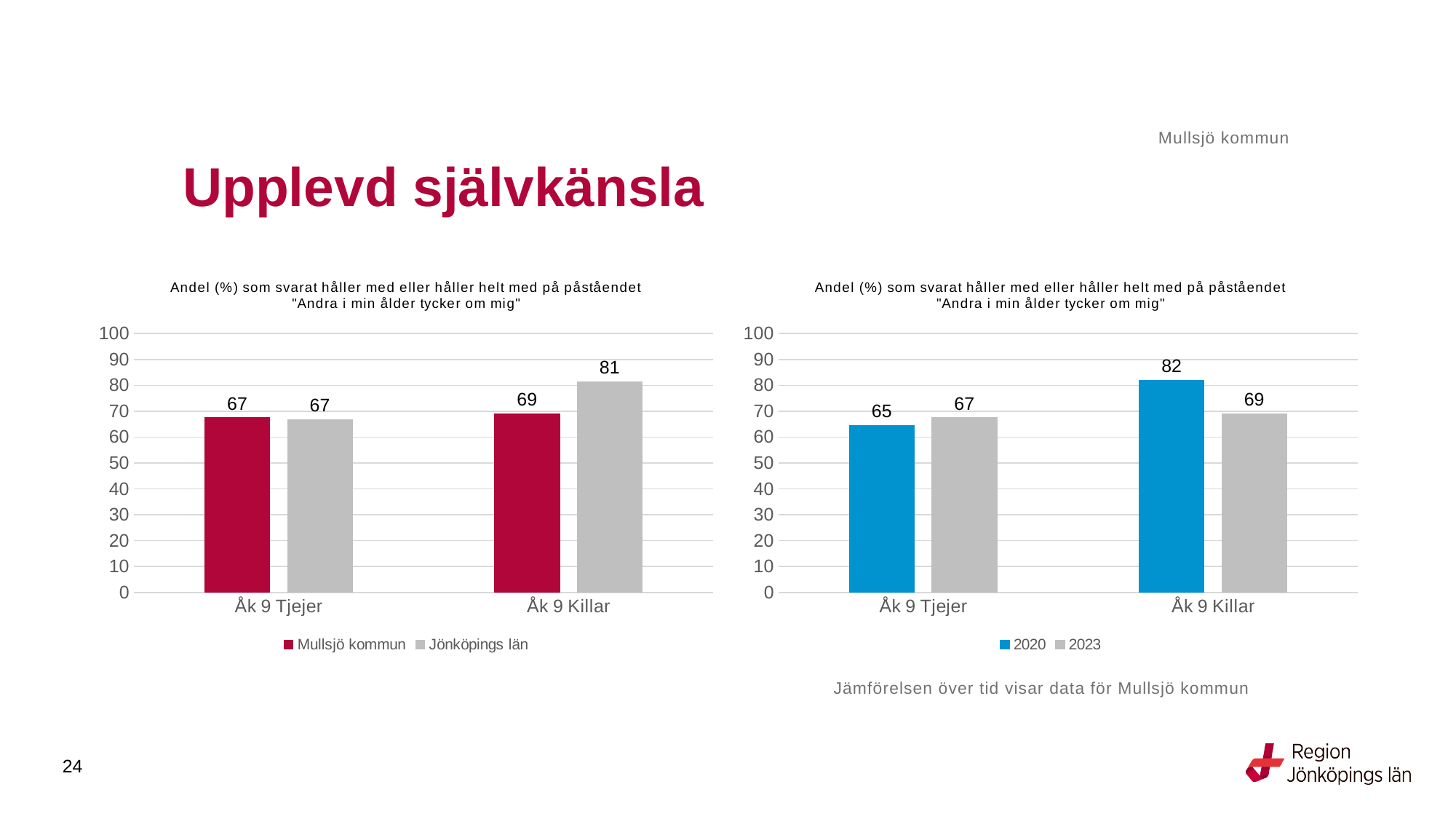
What kind of chart is the left chart? Bar chart In the right chart, what is the value for 2023 for Åk 9 Tjejer? 67 In the left chart, what is the value for Jönköpings län for Åk 9 Killar? 81 In the left chart, which series has the higher value for Åk 9 Killar, Mullsjö kommun or Jönköpings län? Jönköpings län In the right chart, which category has the highest value in the 2020 series? Åk 9 Killar In the left chart, what is the value for Mullsjö kommun for Åk 9 Killar? 69 How many series does the legend of the right chart list? 2 In the right chart, what is the value for 2020 for Åk 9 Killar? 82 In the right chart, what is the difference between 2020 and 2023 for Åk 9 Killar? 13 In the left chart, what is the value for Mullsjö kommun for Åk 9 Tjejer? 67 In the left chart, what is the difference between Jönköpings län and Mullsjö kommun for Åk 9 Killar? 12 In the right chart, which category has the lowest value in the 2020 series? Åk 9 Tjejer